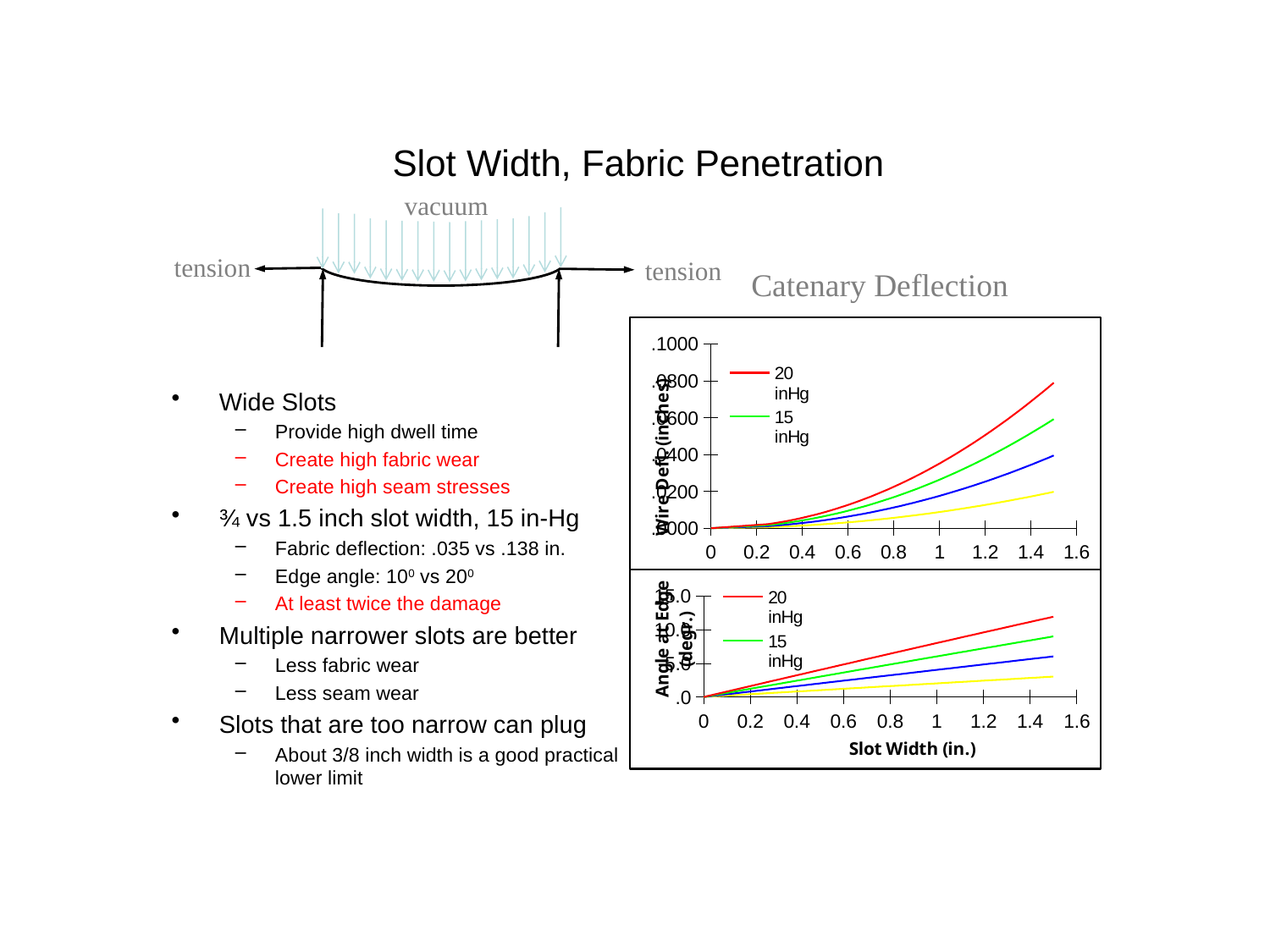
In the bottom chart, does the 15 inHg line rise or fall as slot width increases? rise In the top chart, does the 20 inHg line rise or fall as slot width increases? rise What is the x-axis title of the bottom chart? Slot Width (in.) In the bottom chart, which labelled series reaches the highest angle at a slot width of 1.5? 20 inHg What kind of chart is the top chart (Wire Defl. vs slot width)? line chart What is the largest tick value shown on the x axis of the top chart? 1.6 What kind of chart is the bottom chart (Angle at Edge vs Slot Width)? line chart In the bottom chart, is the angle at edge for 15 inHg at a slot width of 0.4 greater or less than 10.0? less In the top chart, is the wire deflection for 15 inHg at a slot width of 1.2 greater or less than .0200? greater In the top chart, is the wire deflection for 20 inHg at a slot width of 1.4 greater or less than .0600? greater In the top chart, which series is higher at a slot width of 1.4: 20 inHg or 15 inHg? 20 inHg